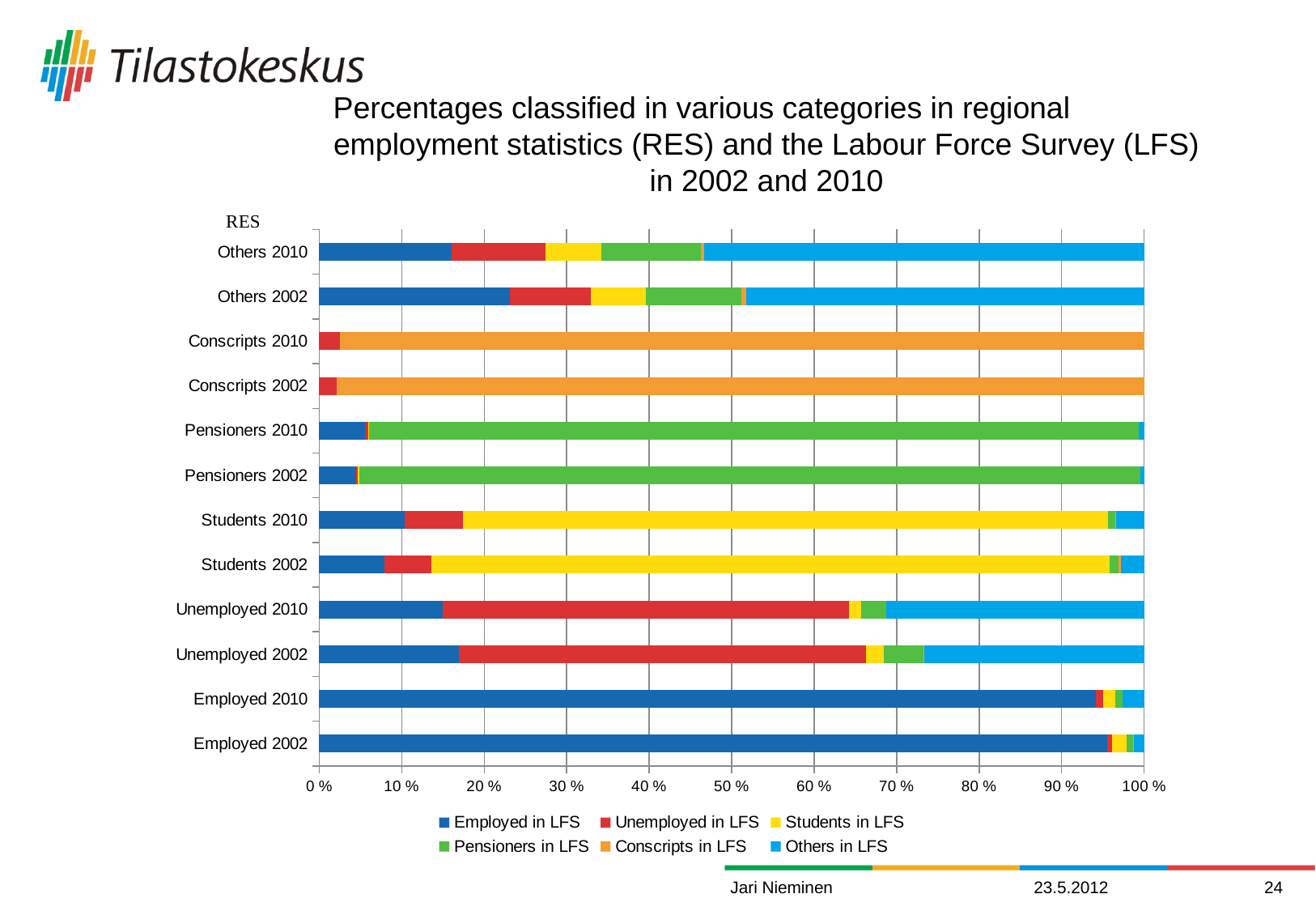
What is the total of the Employed 2002 stacked bar? 100 % Is the Employed in LFS share for Employed 2002 greater or less than 90 %? greater What kind of chart is shown on the slide? Stacked bar chart Is the Employed in LFS share for Others 2010 greater or less than 20 %? less Which colour represents Conscripts in LFS in the legend? Orange Is the Students in LFS share for Students 2002 greater or less than 70 %? greater How many series does the legend list? 6 How many RES categories (bars) are plotted on the chart? 12 Which has the larger Employed in LFS share: Others 2002 or Others 2010? Others 2002